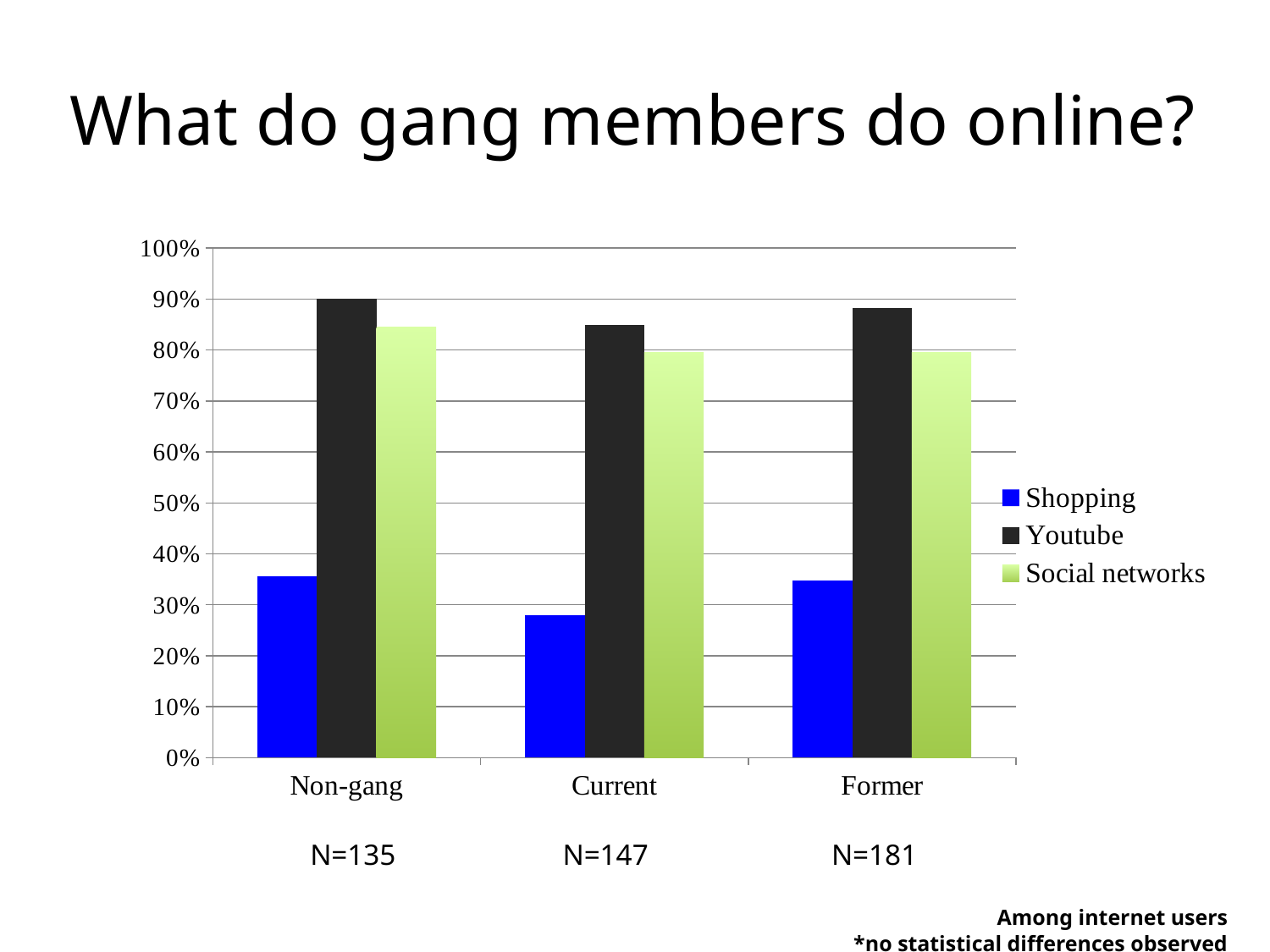
What are the three series listed in the legend? Shopping, Youtube, Social networks Is the Youtube value for Current greater or less than 70%? greater Which category has the lowest Shopping value? Current Is the Youtube value for Non-gang greater or less than 80%? greater How many series does the legend list? 3 How many categories are shown on the x axis? 3 Which series has the highest value in every category? Youtube What kind of chart is shown on the slide? bar chart For the Non-gang category, which is larger: Youtube or Shopping? Youtube Is the Social networks value for Former greater or less than 90%? less What is the sample size (N) shown for the Current category? N=147